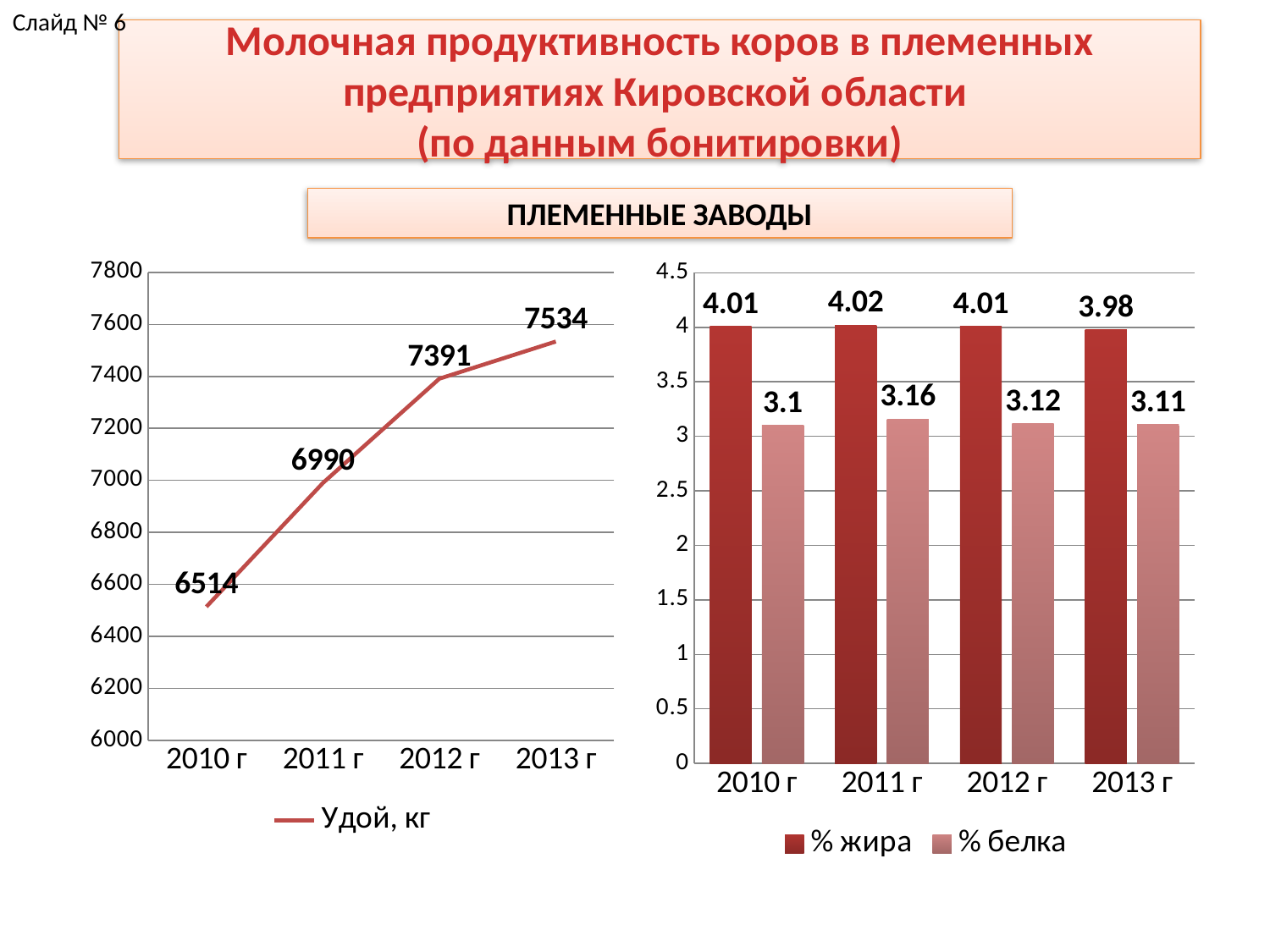
In the right chart, which year has the lowest value of % жира? 2013 г In the right chart, what is the value of % жира for 2013 г? 3.98 How many series does the legend of the right chart list? 2 In the left chart, do the values of Удой, кг rise or fall from 2010 г to 2013 г? rise What kind of chart is the left chart? line chart In the left chart, what is the value of Удой, кг for 2013 г? 7534 In the right chart, what is the value of % белка for 2011 г? 3.16 In the left chart, by how much did Удой, кг increase from 2010 г to 2013 г? 1020 In the right chart, what is the difference between % жира and % белка in 2010 г? 0.91 In the right chart, which year has the highest value of % белка? 2011 г In the left chart, what is the value of Удой, кг for 2010 г? 6514 What kind of chart is the right chart? bar chart